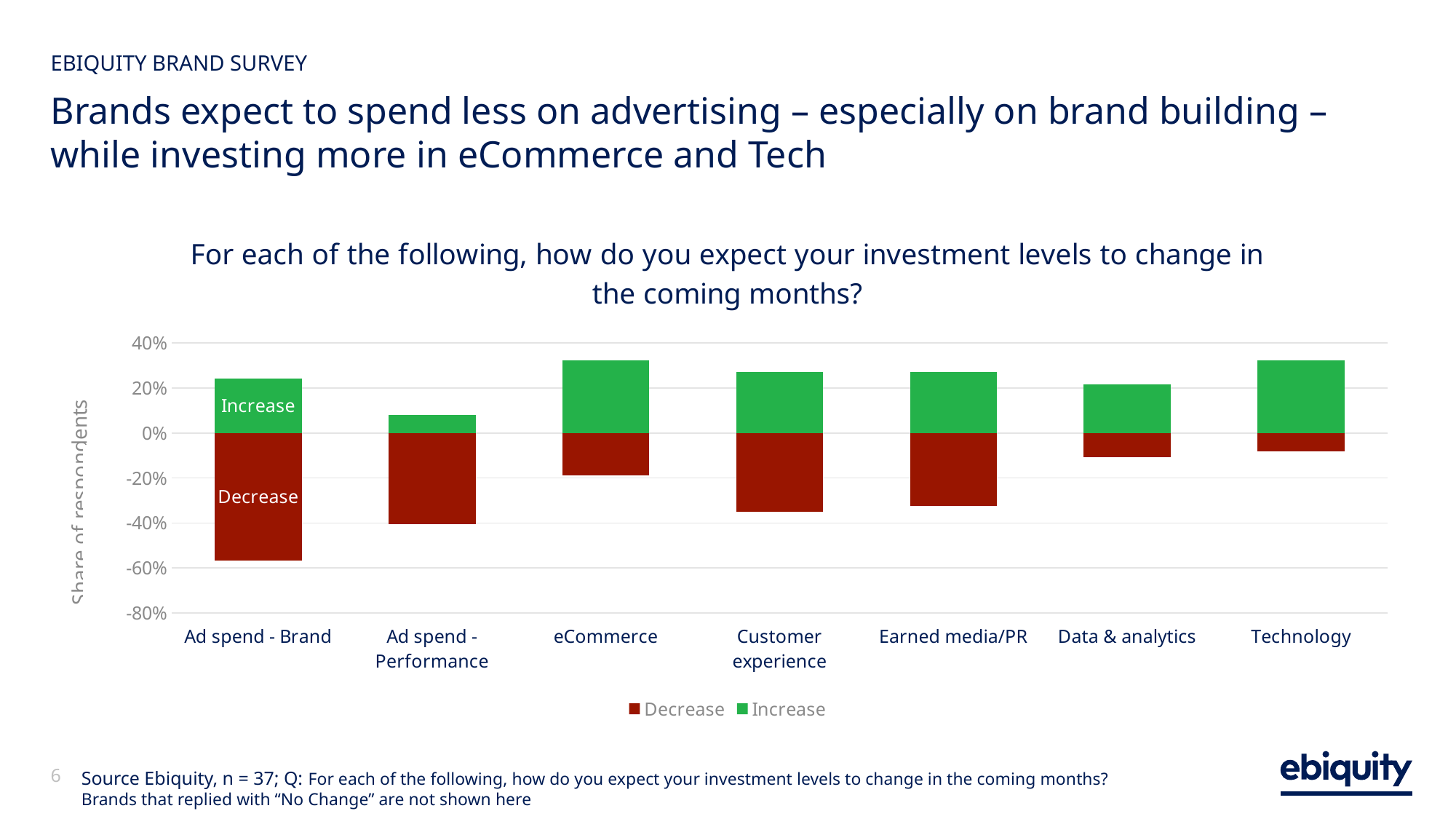
Is the Increase value for Ad spend - Performance greater or less than 20%? less Is the Decrease value for Ad spend - Brand greater or less than -40%? less How many categories are shown on the x axis of the chart? 7 Is the Increase value for Ad spend - Brand larger or smaller than the Increase value for Ad spend - Performance? larger Which colour represents the Decrease series in the chart? red What is the label of the chart's vertical axis? Share of respondents How many series does the chart's legend list? 2 What kind of chart is shown on the slide? bar chart Which category has the smallest Increase share (the shortest green bar)? Ad spend - Performance Is the Decrease value for Data & analytics greater or less than -20%? greater Which category has the largest Decrease share (the longest red bar)? Ad spend - Brand